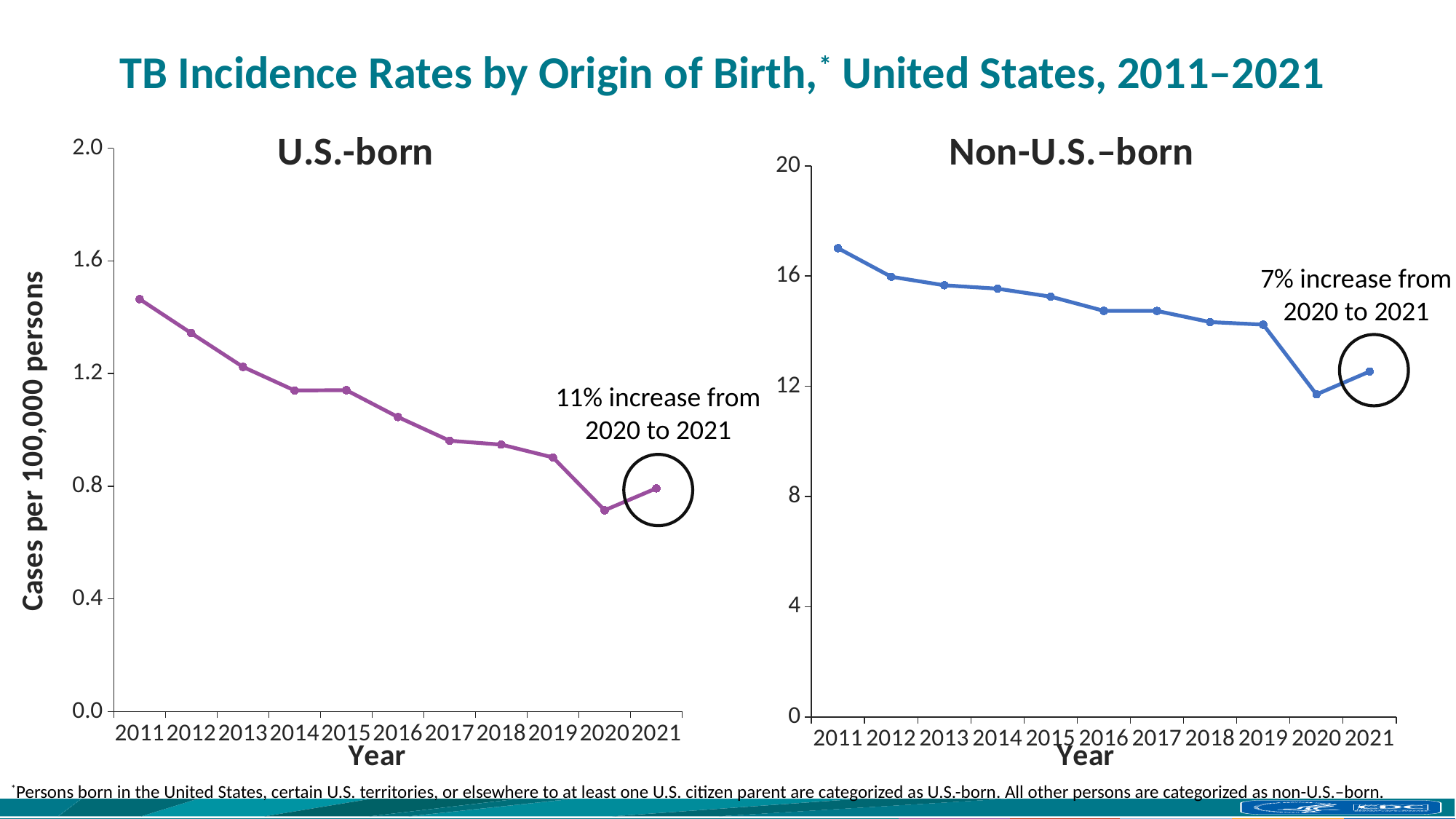
In the Non-U.S.-born chart, which year has the lowest incidence rate? 2020 In the Non-U.S.-born chart, is the value for 2011 greater or less than 16? greater In the U.S.-born chart, is the value for 2011 greater or less than 1.2? greater In the U.S.-born chart, how many years are plotted along the x axis? 11 In the Non-U.S.-born chart, is the value for 2016 greater or less than 16? less In the Non-U.S.-born chart, which year has the highest incidence rate? 2011 In the U.S.-born chart, which year has the lowest incidence rate? 2020 In the Non-U.S.-born chart, which year has the larger value, 2019 or 2020? 2019 What kind of chart is the U.S.-born chart? line chart In the U.S.-born chart, what is the overall trend in incidence rates from 2011 to 2020? falling According to the annotation on the Non-U.S.-born chart, what was the percentage increase from 2020 to 2021? 7%